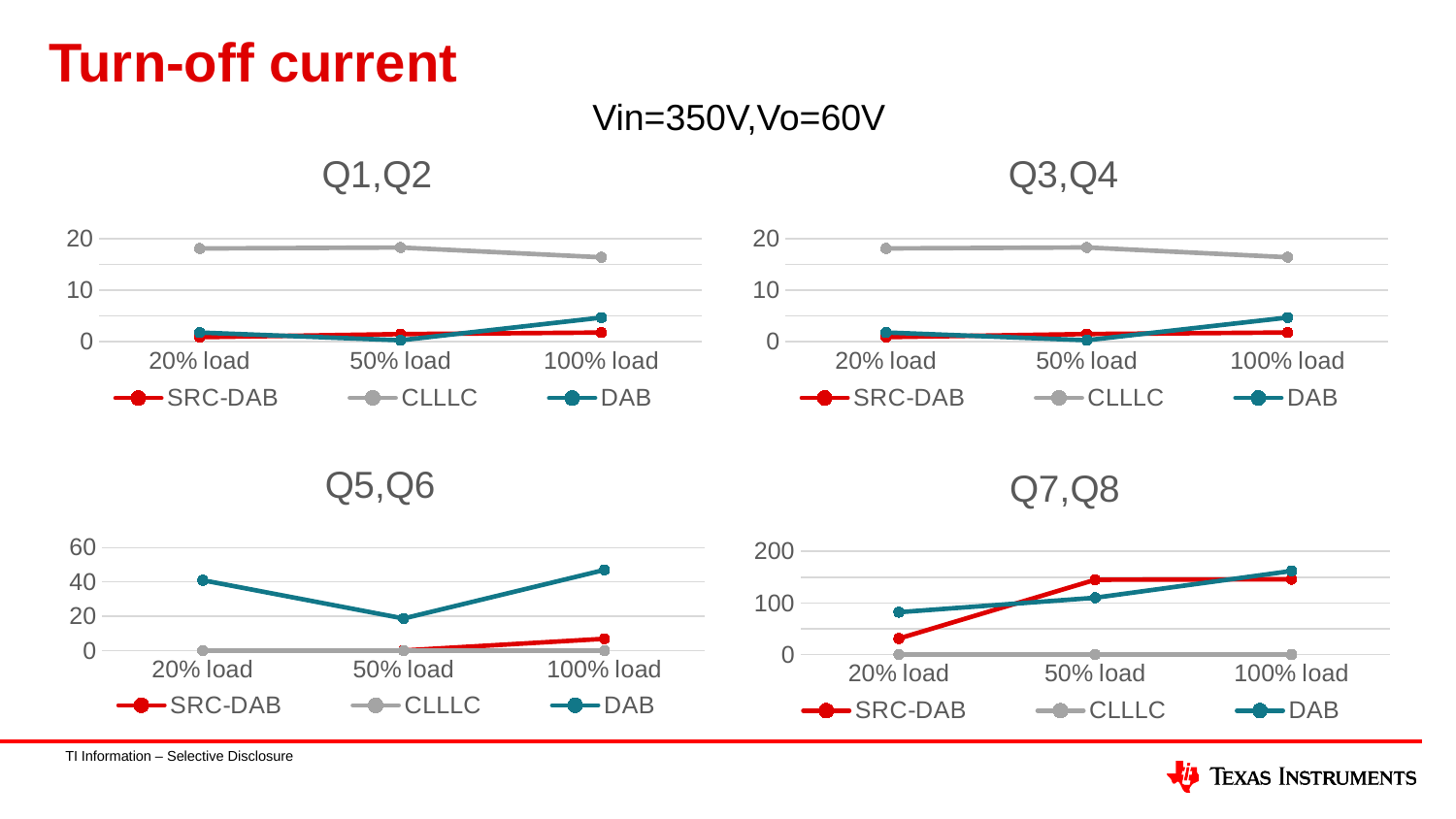
How many charts are shown on the slide? 4 In the Q5,Q6 chart, which series has the highest value at 20% load? DAB In the Q5,Q6 chart, is the value for DAB at 50% load greater or less than 40? less In the Q1,Q2 chart, what kind of chart is shown? line chart In the Q1,Q2 chart, does the CLLLC series rise or fall from 50% load to 100% load? fall In the Q7,Q8 chart, at 20% load, which is larger: DAB or SRC-DAB? DAB In the Q7,Q8 chart, which series has the lowest value at 100% load? CLLLC In the Q5,Q6 chart, how many series does the legend list? 3 In the Q7,Q8 chart, how many load categories are shown on the x axis? 3 In the Q7,Q8 chart, does the DAB series rise or fall from 20% load to 100% load? rise In the Q1,Q2 chart, is the value for CLLLC at 20% load greater or less than 10? greater In the Q7,Q8 chart, is the value for SRC-DAB at 50% load greater or less than 100? greater